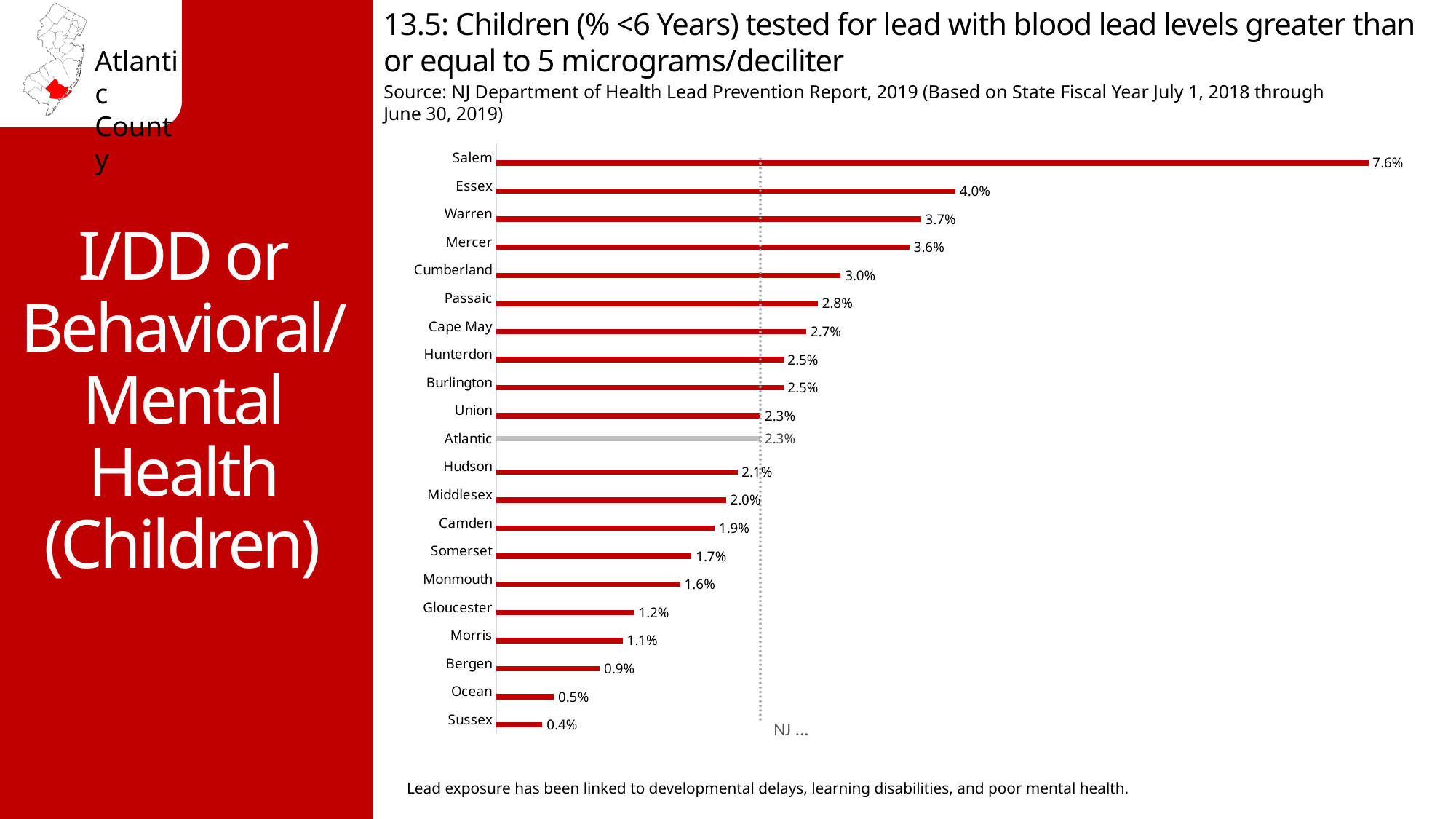
What is the difference between the values for Salem and Essex? 3.6% What is the difference between the values for Atlantic and Sussex? 1.9% How many counties are shown on the chart? 21 What type of chart is shown on the slide? Bar chart Which has a higher value, Mercer or Passaic? Mercer Which county has the lowest percentage on the chart? Sussex What percentage of children tested in Salem had blood lead levels greater than or equal to 5 micrograms/deciliter? 7.6% Which has a higher value, Gloucester or Camden? Camden What is the value shown for Atlantic County? 2.3% What is the value shown for Cumberland? 3.0% Which county's bar is shown in gray rather than red? Atlantic Which county has the highest percentage on the chart? Salem